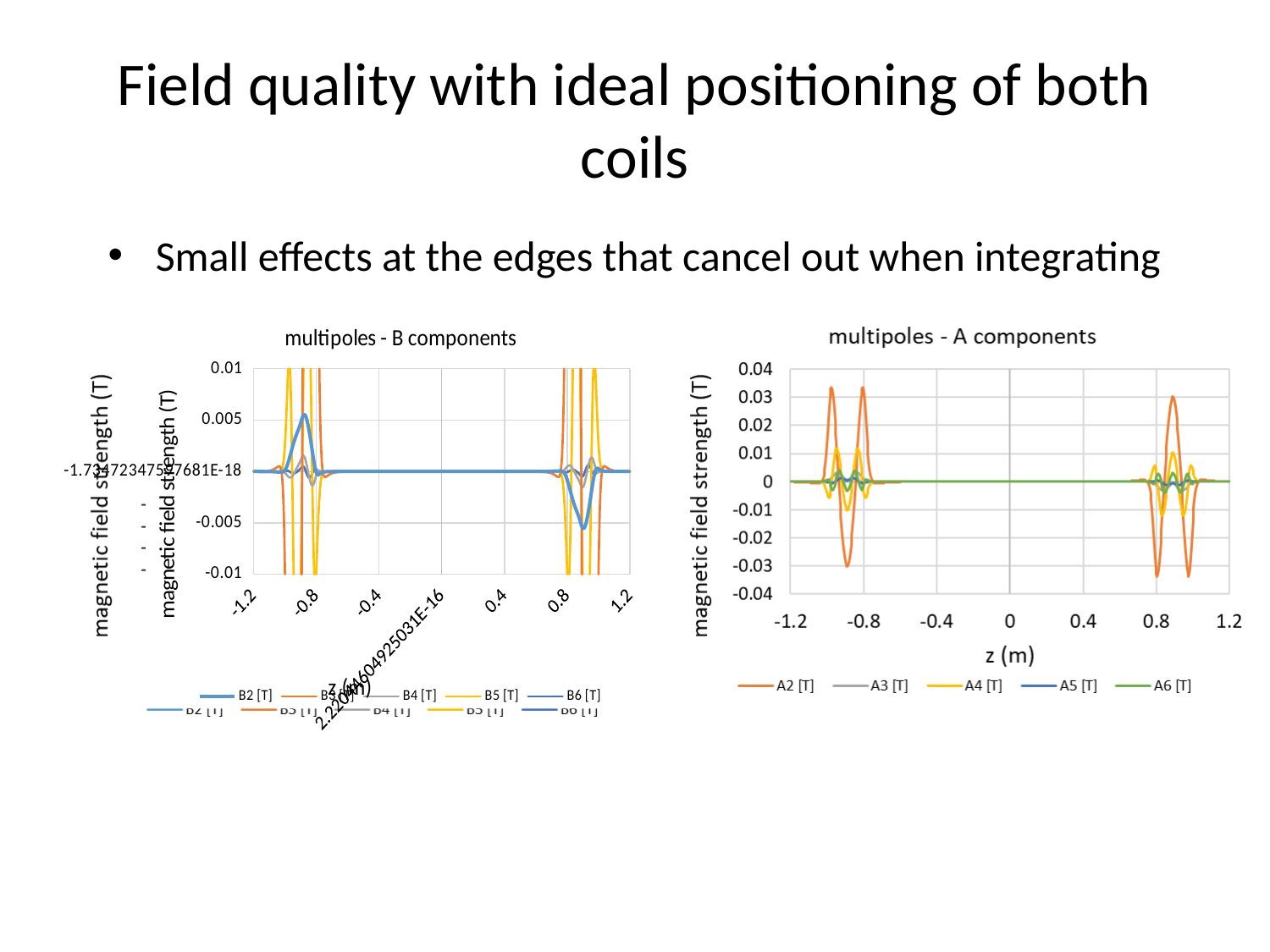
What kind of chart is the 'multipoles - B components' chart? line chart In the 'multipoles - A components' chart, what is the highest value shown on the y-axis? 0.04 How many series does the legend of the 'multipoles - B components' chart list? 5 In the 'multipoles - A components' chart, which series is drawn in orange? A2 [T] How many series does the legend of the 'multipoles - A components' chart list? 5 In the 'multipoles - A components' chart, which series reaches the highest peak value? A2 [T] In the 'multipoles - A components' chart, is the maximum value of A2 [T] greater or less than 0.02? greater What is the x-axis label of the 'multipoles - A components' chart? z (m) What kind of chart is the 'multipoles - A components' chart? line chart In the 'multipoles - A components' chart, is the minimum value of A2 [T] greater or less than -0.02? less In the 'multipoles - B components' chart, is the maximum value of B2 [T] greater or less than 0.01? less